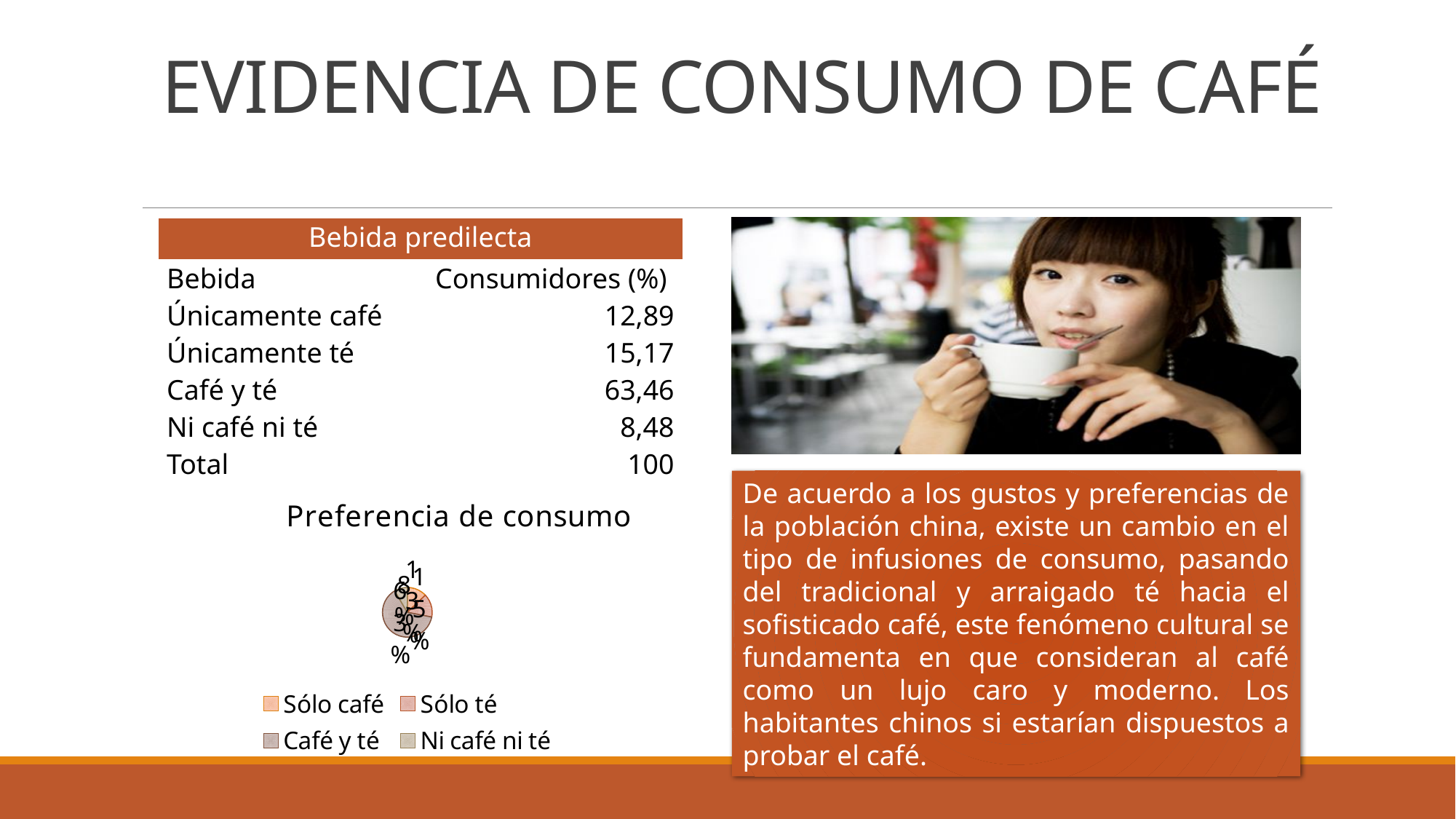
In the "Preferencia de consumo" pie chart, which category has the largest slice? Café y té What kind of chart is shown under the title "Preferencia de consumo"? pie chart Which legend entries are listed for the "Preferencia de consumo" pie chart? Sólo café, Sólo té, Café y té, Ni café ni té How many categories does the legend of the "Preferencia de consumo" pie chart list? 4 What is the title of the chart on the slide? Preferencia de consumo